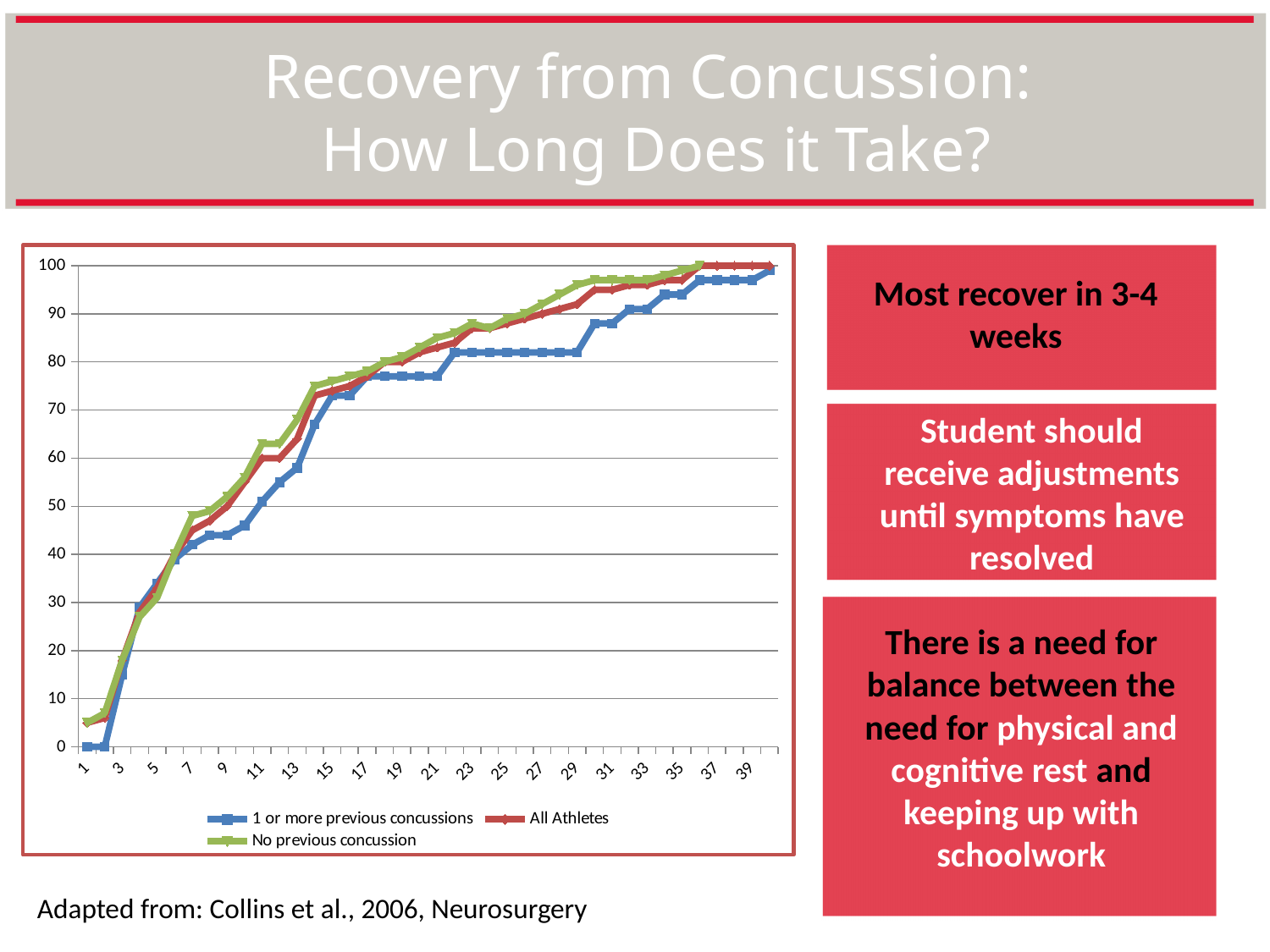
Which series is drawn in red? All Athletes At x = 21, which series has the higher value: 'No previous concussion' or '1 or more previous concussions'? No previous concussion What kind of chart is shown on the slide? line chart What is the highest value shown on the y axis? 100 Do the values for the 'No previous concussion' series rise or fall along the x axis? rise Is the value for '1 or more previous concussions' at x = 21 greater or less than 80? less Is the value for 'All Athletes' at x = 7 greater or less than 40? greater Which series is drawn in blue? 1 or more previous concussions Is the value for 'No previous concussion' at x = 15 greater or less than 70? greater How many series does the chart legend list? 3 At x = 29, which series has the higher value: 'All Athletes' or '1 or more previous concussions'? All Athletes